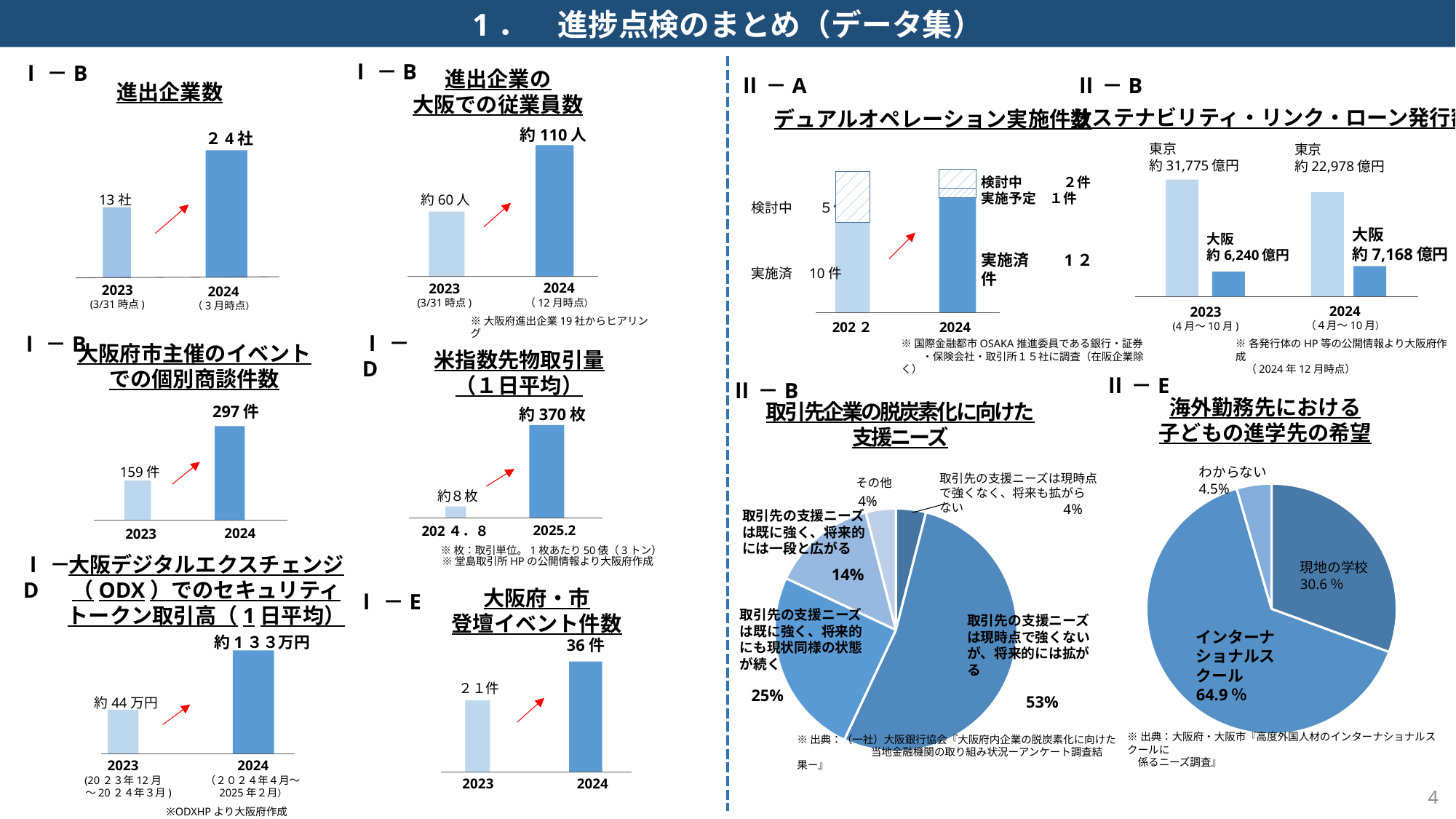
In the 米指数先物取引量（１日平均） chart, what is the value for 2025.2? 約370枚 In the 取引先企業の脱炭素化に向けた支援ニーズ pie chart, what is the largest slice's percentage? 53% In the サステナビリティ・リンク・ローン発行額 chart, what is the 大阪 value for 2024? 約7,168億円 In the デュアルオペレーション実施件数 chart, what is the total of the 2024 stacked bar (検討中 + 実施予定 + 実施済)? 15件 In the デュアルオペレーション実施件数 chart, what is the 実施済 value for 2024? １２件 In the 海外勤務先における子どもの進学先の希望 pie chart, what share is インターナショナルスクール? 64.9％ In the 大阪府・市登壇イベント件数 chart, what is the value for 2024? 36件 In the 大阪府・市登壇イベント件数 chart, which year has the higher value, 2023 or 2024? 2024 In the 進出企業数 chart, what is the difference between the 2024 and 2023 values? 11社 In the 進出企業数 chart, what is the value for 2024? ２４社 In the 大阪府市主催のイベントでの個別商談件数 chart, what is the value for 2023? 159件 In the 大阪府市主催のイベントでの個別商談件数 chart, how much higher is 2024 than 2023? 138件